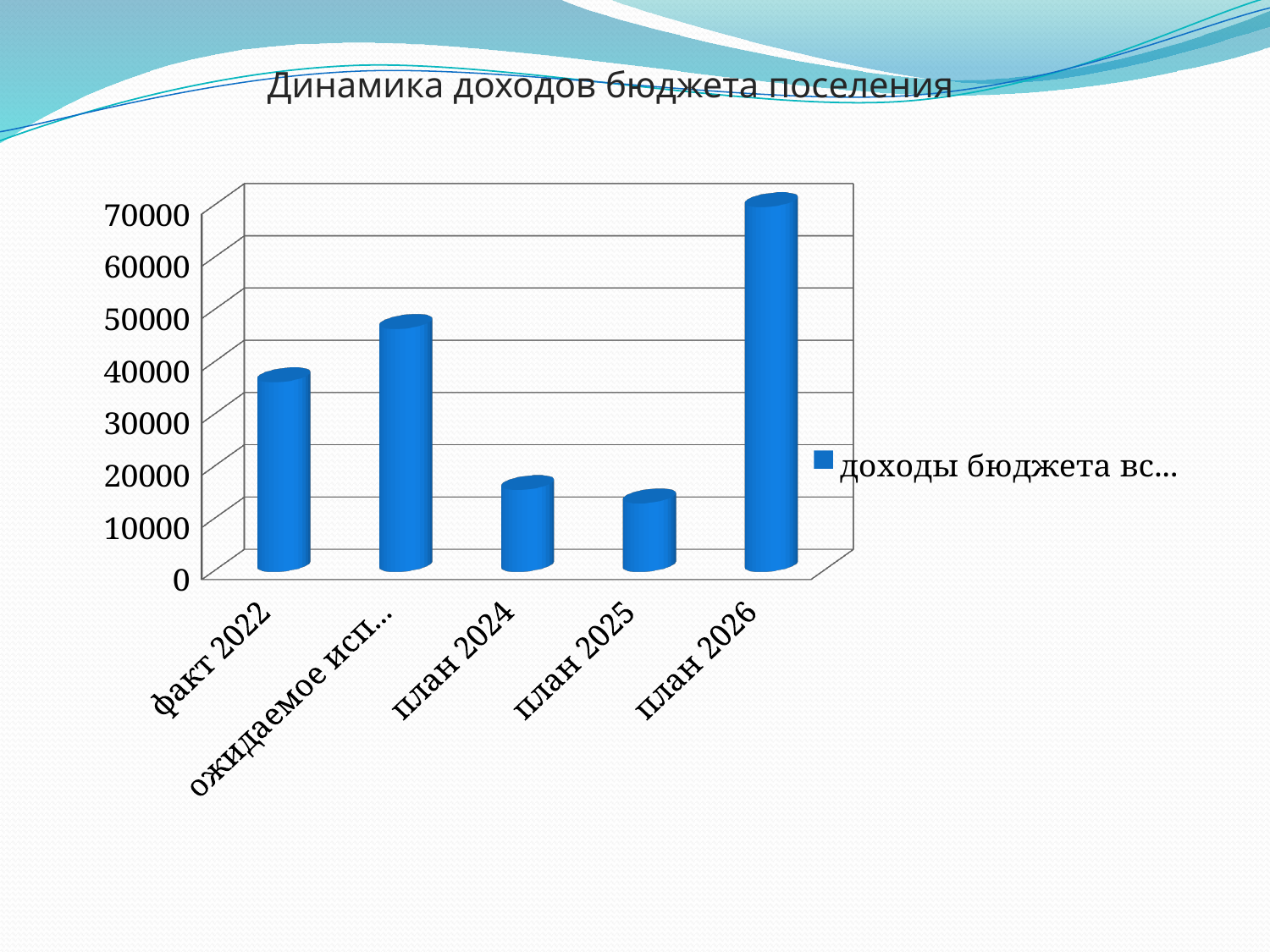
What type of chart is shown on the slide? bar chart Which category has the lowest value? план 2025 What is the title of the chart? Динамика доходов бюджета поселения How many categories are shown on the x axis of the chart? 5 Is the value for план 2025 greater or less than 20000? less Which is larger, the value for факт 2022 or the value for план 2024? факт 2022 Is the value for факт 2022 greater or less than 30000? greater Does the value rise or fall from план 2025 to план 2026? rise Is the value for план 2026 greater or less than 60000? greater How many series does the legend list? 1 Which category has the highest value? план 2026